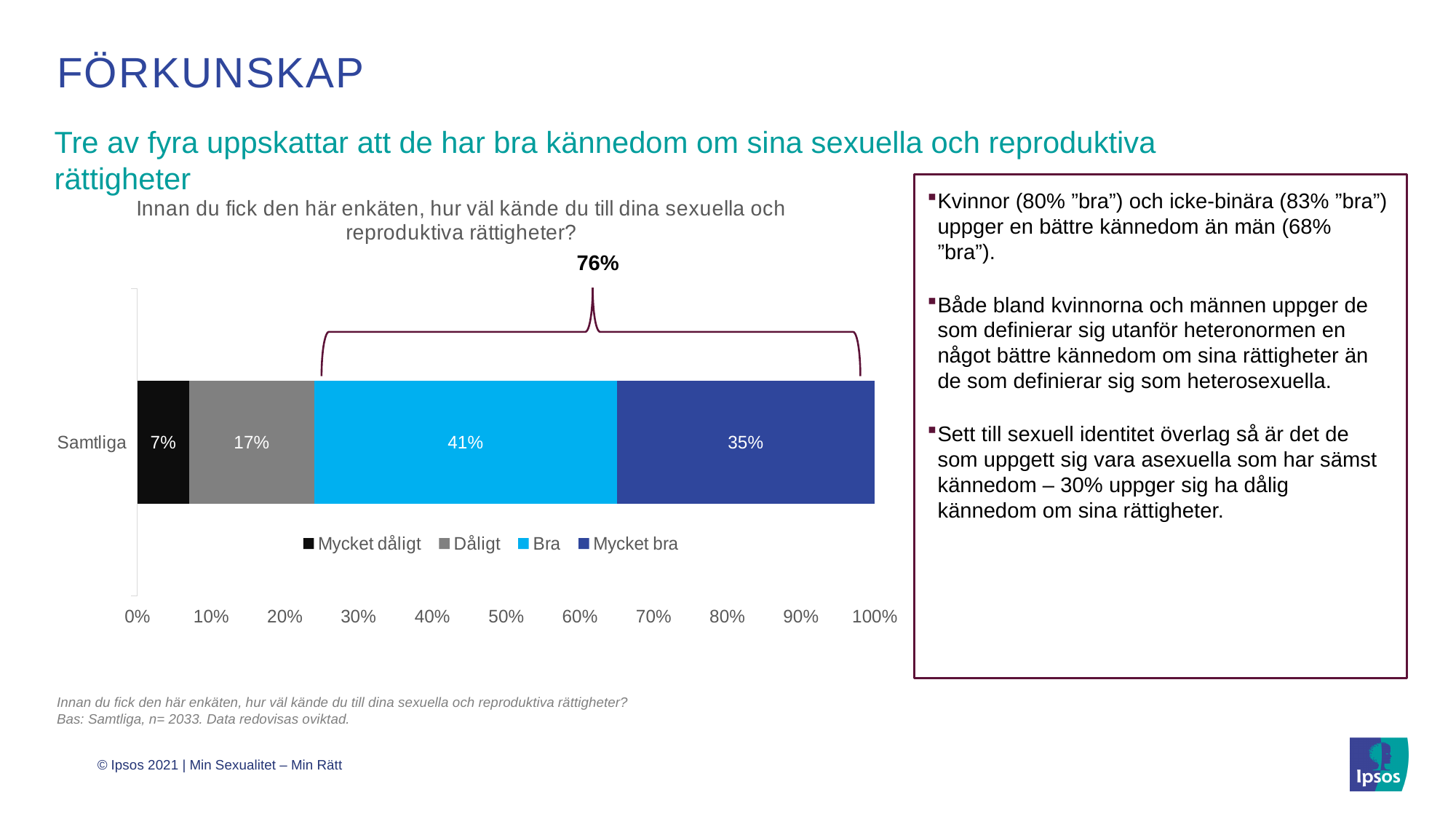
What kind of chart is shown on the slide? Stacked bar chart What percentage of respondents answered "Mycket dåligt"? 7% What percentage of respondents answered "Mycket bra"? 35% Which response category has the smallest share in the chart? Mycket dåligt What is the difference in percentage points between "Bra" and "Mycket bra"? 6 percentage points What percentage of respondents answered "Bra" in the chart? 41% How many series does the legend list? 4 What percentage of respondents answered "Dåligt"? 17% Which response category has the largest share in the chart? Bra What is the label of the single category on the y axis of the chart? Samtliga What is the combined share of "Bra" and "Mycket bra" shown above the bracket? 76% Which is larger, the share for "Dåligt" or the share for "Mycket bra"? Mycket bra